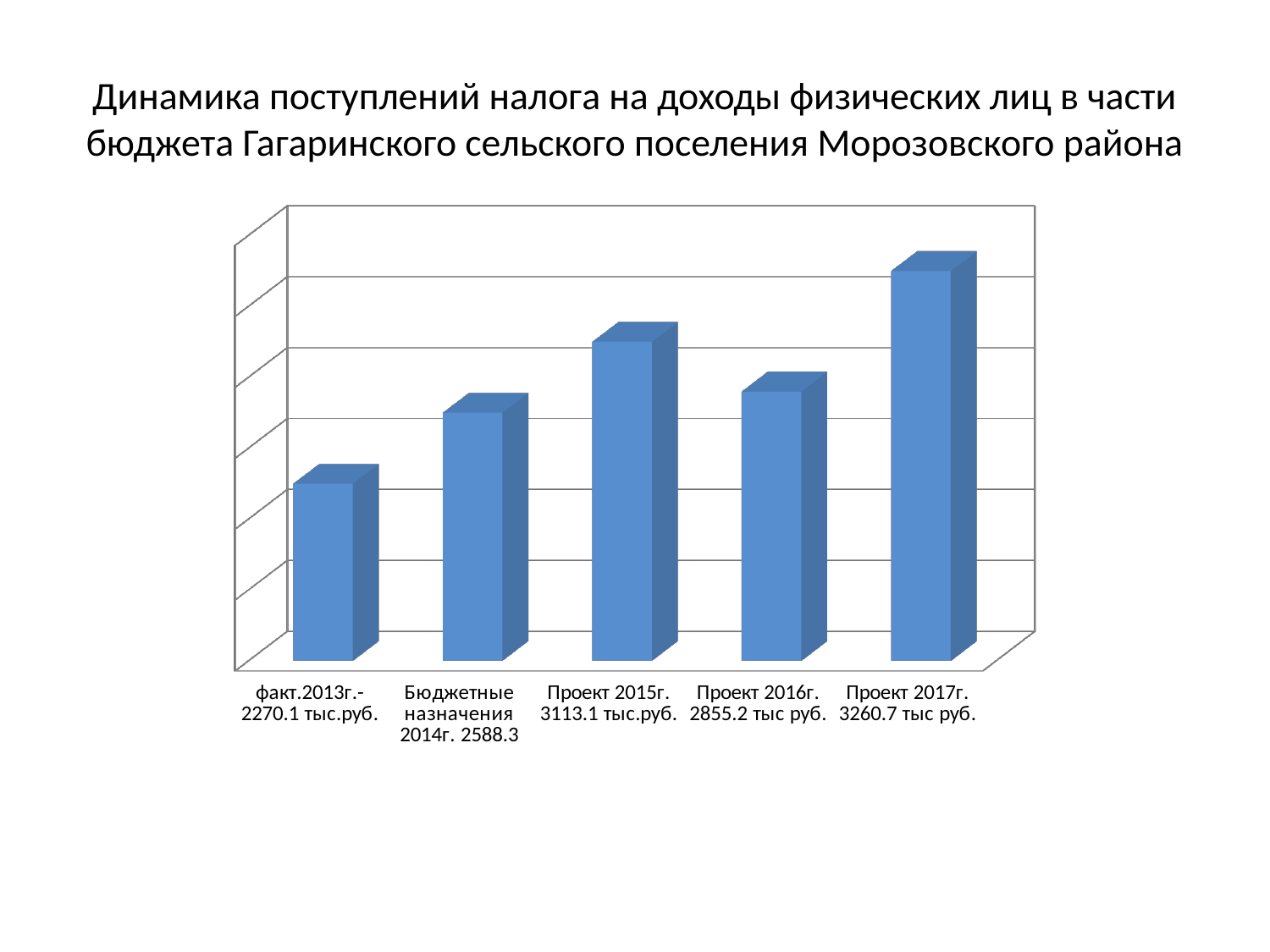
What is the value for факт.2013г.? 2270.1 тыс.руб. Which is larger, the value for Проект 2015г. or the value for Проект 2016г.? Проект 2015г. What is the value for Проект 2017г.? 3260.7 тыс руб. Which category has the lowest value? факт.2013г. Which category has the highest value? Проект 2017г. What kind of chart is shown on the slide? Bar chart What is the value for Бюджетные назначения 2014г.? 2588.3 What is the value for Проект 2015г.? 3113.1 тыс.руб. What is the difference between the values for Проект 2015г. and Проект 2016г.? 257.9 What is the value for Проект 2016г.? 2855.2 тыс руб. How many bars (categories) does the chart show? 5 What is the difference between the values for Проект 2017г. and факт.2013г.? 990.6